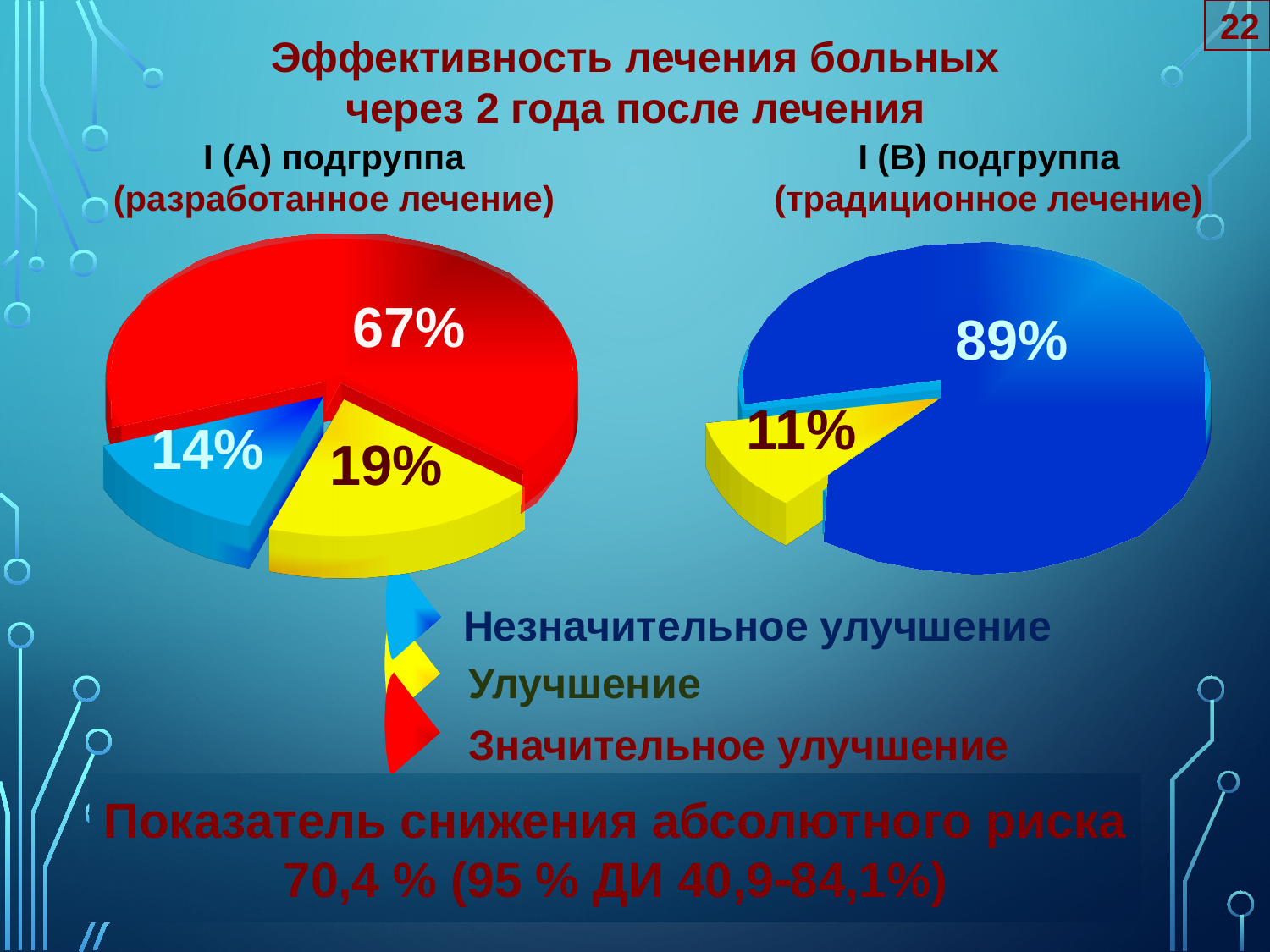
What kind of charts are shown on the slide? Pie charts In the left pie chart (I (A) подгруппа, разработанное лечение), what share is labelled on the red slice (Значительное улучшение)? 67% In the right pie chart (I (B) подгруппа), what share is labelled on the yellow slice (Улучшение)? 11% In the left pie chart (I (A) подгруппа), what share is labelled on the yellow slice (Улучшение)? 19% How many categories does the legend list? 3 In the left pie chart (I (A) подгруппа), which category has the smallest share? Незначительное улучшение In the left pie chart (I (A) подгруппа), which category has the largest share? Значительное улучшение In the left pie chart (I (A) подгруппа), what is the difference between the red slice (67%) and the yellow slice (19%)? 48% In the right pie chart (I (B) подгруппа, традиционное лечение), what share is labelled on the blue slice? 89% How many slices does the left pie chart (I (A) подгруппа) have? 3 In the left pie chart (I (A) подгруппа), what share is labelled on the blue slice (Незначительное улучшение)? 14% How many slices does the right pie chart (I (B) подгруппа) have? 2